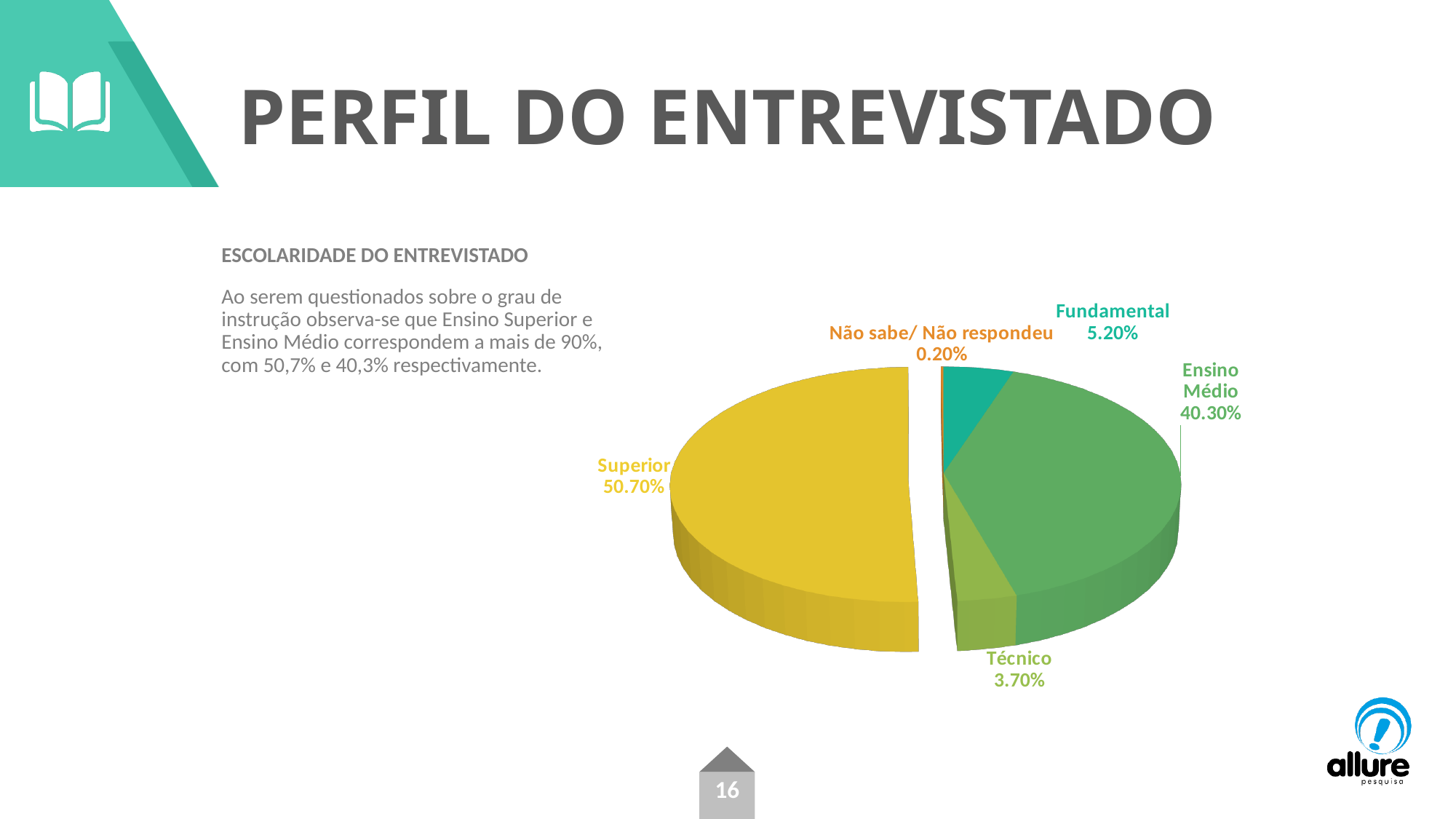
Which category has the largest share of the pie? Superior What is the value for Ensino Médio? 40.30% What colour is the Superior slice? yellow What is the value for Não sabe/ Não respondeu? 0.20% What is the value for Superior? 50.70% What is the value for Fundamental? 5.20% What is the value for Técnico? 3.70% What is the difference between the values for Superior and Ensino Médio? 10.40% Which category has the smallest share of the pie? Não sabe/ Não respondeu How many categories are shown in the pie chart? 5 What type of chart is shown on the slide? pie chart Which is larger, Fundamental or Técnico? Fundamental